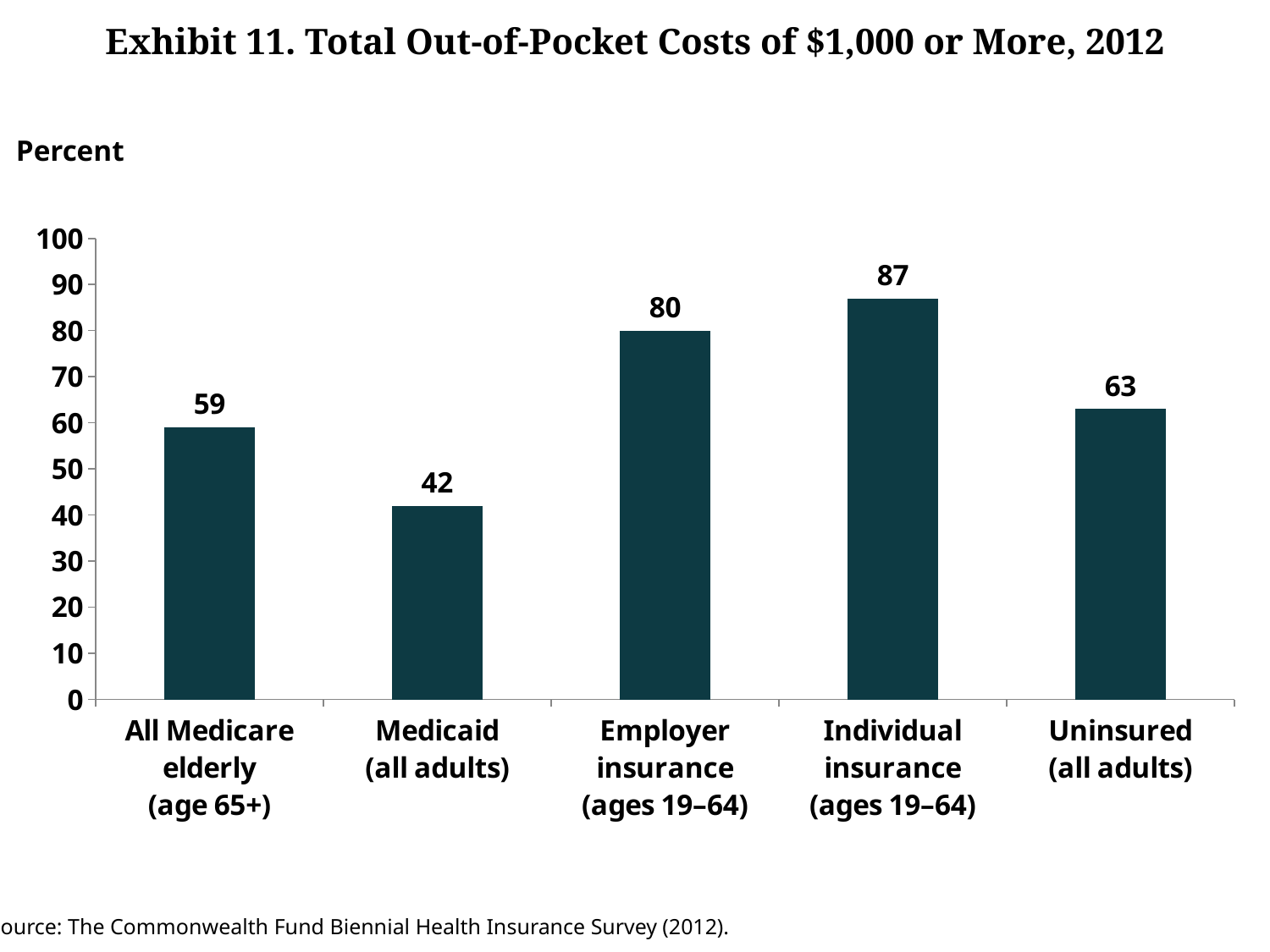
What is the difference between the values for Employer insurance (ages 19–64) and All Medicare elderly (age 65+)? 21 Is the value for Employer insurance (ages 19–64) greater or less than 70? greater Which category has the highest value? Individual insurance (ages 19–64) What kind of chart is shown on the slide? bar chart What is the value for Uninsured (all adults)? 63 What is the difference between the values for Individual insurance (ages 19–64) and Medicaid (all adults)? 45 What is the value for Individual insurance (ages 19–64)? 87 Which category has the lowest value? Medicaid (all adults) What is the value for Medicaid (all adults)? 42 What is the title of the chart? Exhibit 11. Total Out-of-Pocket Costs of $1,000 or More, 2012 Which is larger, the value for Uninsured (all adults) or the value for All Medicare elderly (age 65+)? Uninsured (all adults) How many categories are shown on the chart? 5